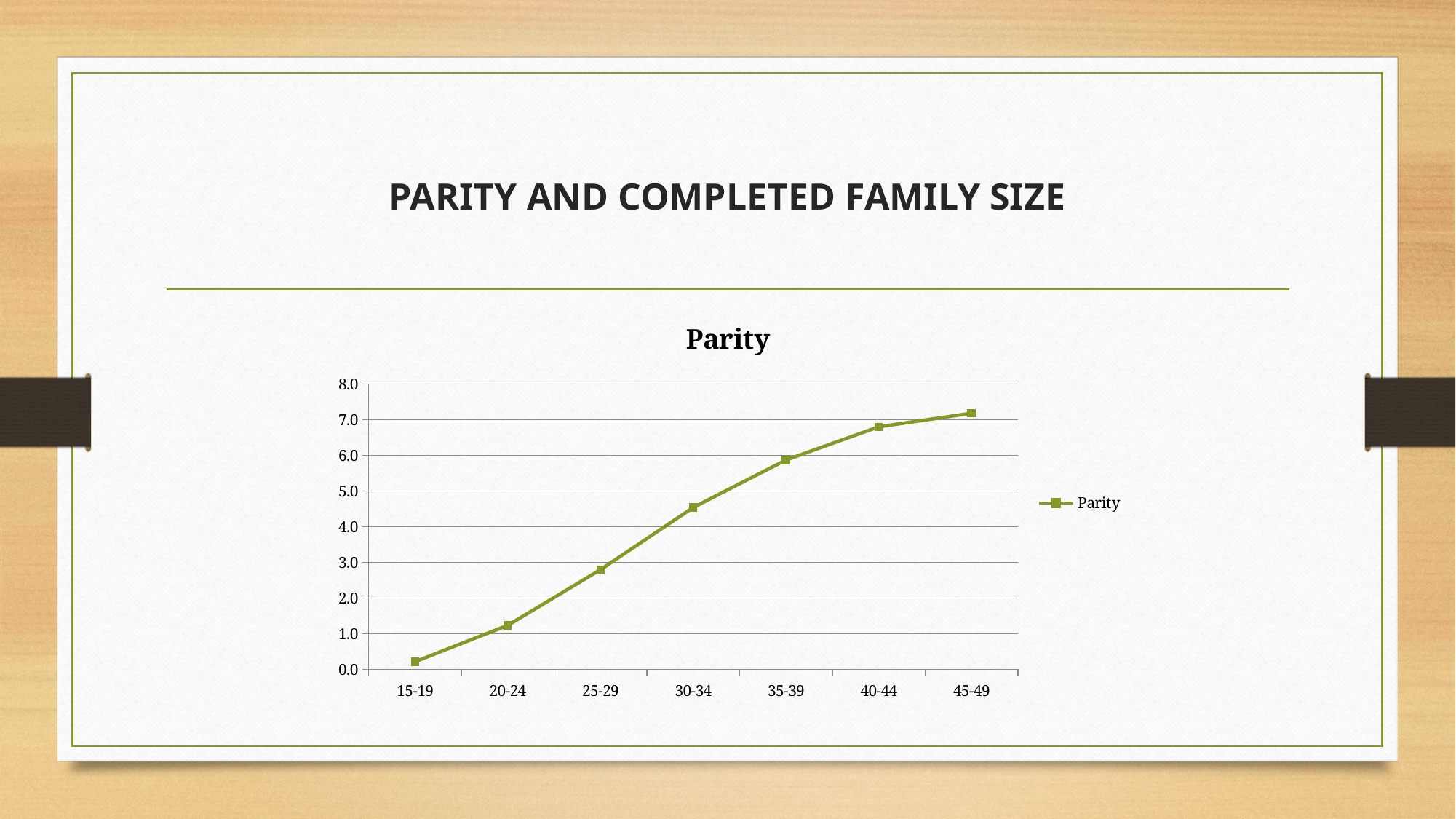
Which has a larger parity value, 25-29 or 35-39? 35-39 What is the title of the chart? Parity Is the parity value for 20-24 greater or less than 2.0? less Which age group has the highest parity value? 45-49 How many series does the legend list? 1 Which age group has the lowest parity value? 15-19 Is the parity value for 30-34 greater or less than 4.0? greater What is the highest value shown on the y axis? 8.0 Is the parity value for 45-49 greater or less than 7.0? greater How many age-group categories are plotted on the x axis? 7 Do the parity values rise or fall as age group increases along the x axis? rise What kind of chart is shown on the slide? line chart